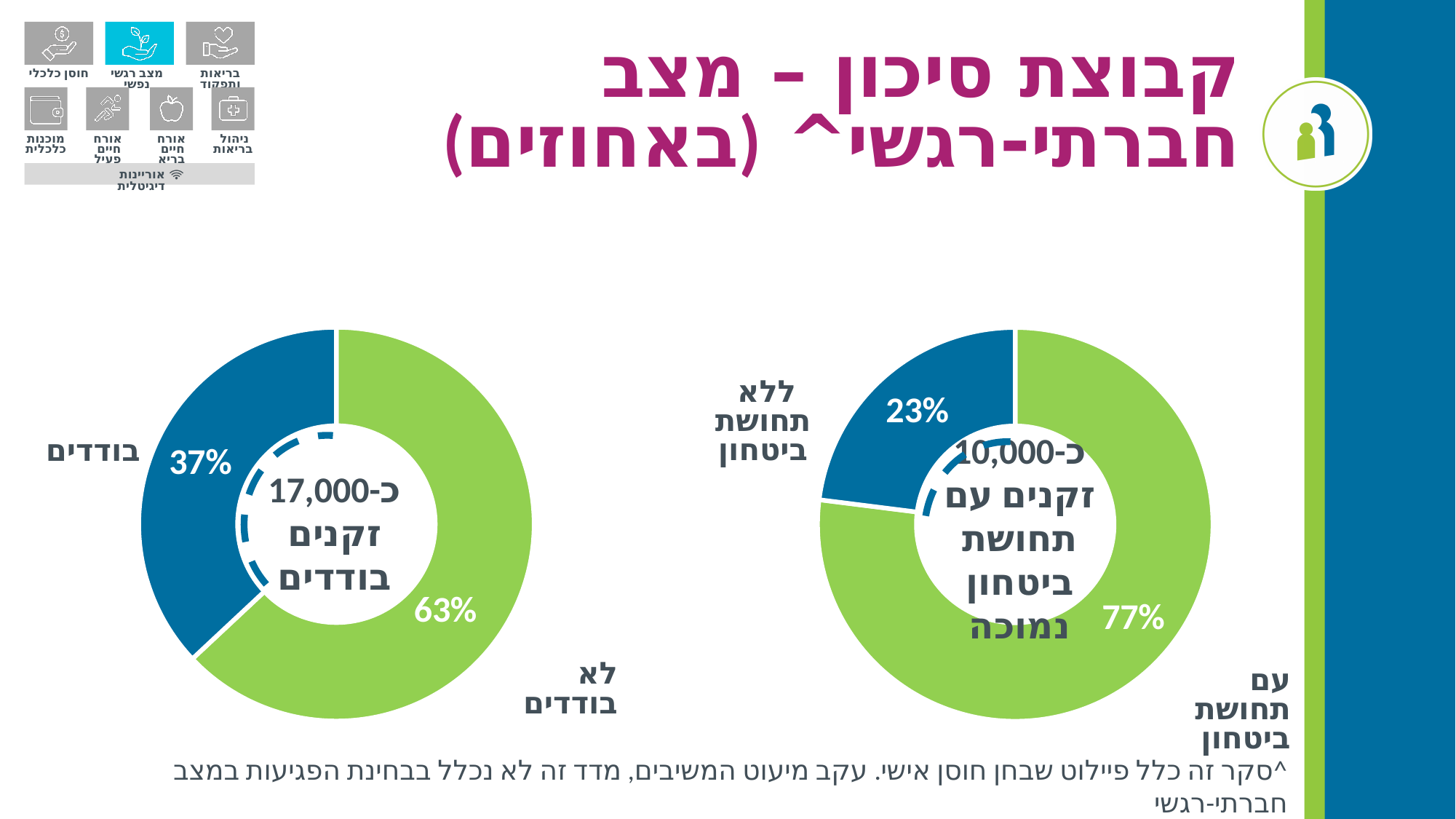
In the left donut chart, what percentage is shown for the slice labelled "בודדים"? 37% In the left donut chart, what is the difference in percentage points between the "לא בודדים" slice and the "בודדים" slice? 26 In the right donut chart, what percentage is shown for the slice labelled "ללא תחושת ביטחון"? 23% What number of elderly people is written in the centre of the left donut chart? כ-17,000 In the right donut chart, which slice is the smallest? ללא תחושת ביטחון Which is larger: the "בודדים" slice in the left chart or the "ללא תחושת ביטחון" slice in the right chart? בודדים In the right donut chart, what is the difference in percentage points between the "עם תחושת ביטחון" slice and the "ללא תחושת ביטחון" slice? 54 What type of chart is used on the right side of the slide? Donut (pie) chart In the left donut chart, which slice is the largest? לא בודדים In the right donut chart, what percentage is shown for the slice labelled "עם תחושת ביטחון"? 77% How many slices does the left donut chart have? 2 In the left donut chart, what percentage is shown for the slice labelled "לא בודדים"? 63%